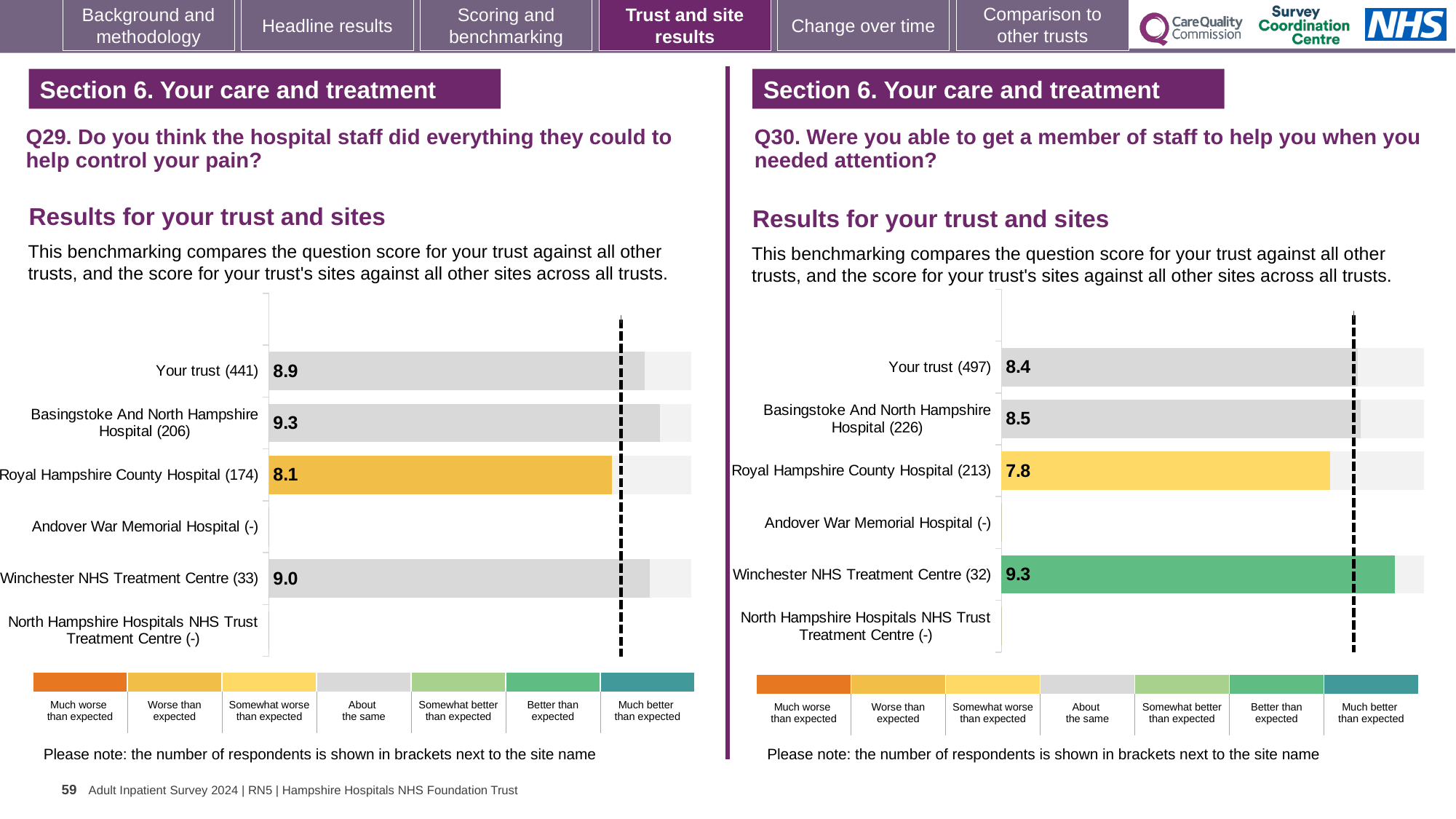
On the Q29 chart (left), which site has the highest score? Basingstoke And North Hampshire Hospital (206) On the Q30 chart (right), what is the difference between the scores for Winchester NHS Treatment Centre and Your trust? 0.9 On the Q30 chart (right), what is the score for Your trust (497)? 8.4 On the Q29 chart (left), what is the score for Your trust (441)? 8.9 On the Q30 chart (right), how many sites have a score shown? 3 On the Q30 chart (right), which is larger: the score for Winchester NHS Treatment Centre or the score for Basingstoke And North Hampshire Hospital? Winchester NHS Treatment Centre What kind of chart is used on the Q29 chart (left)? Bar chart On the Q29 chart (left), which site has the lowest score? Royal Hampshire County Hospital (174) On the Q30 chart (right), which site has the lowest score? Royal Hampshire County Hospital (213) On the Q29 chart (left), what is the score for Royal Hampshire County Hospital (174)? 8.1 On the Q29 chart (left), what is the difference between the scores for Basingstoke And North Hampshire Hospital and Royal Hampshire County Hospital? 1.2 On the Q30 chart (right), what is the score for Winchester NHS Treatment Centre (32)? 9.3